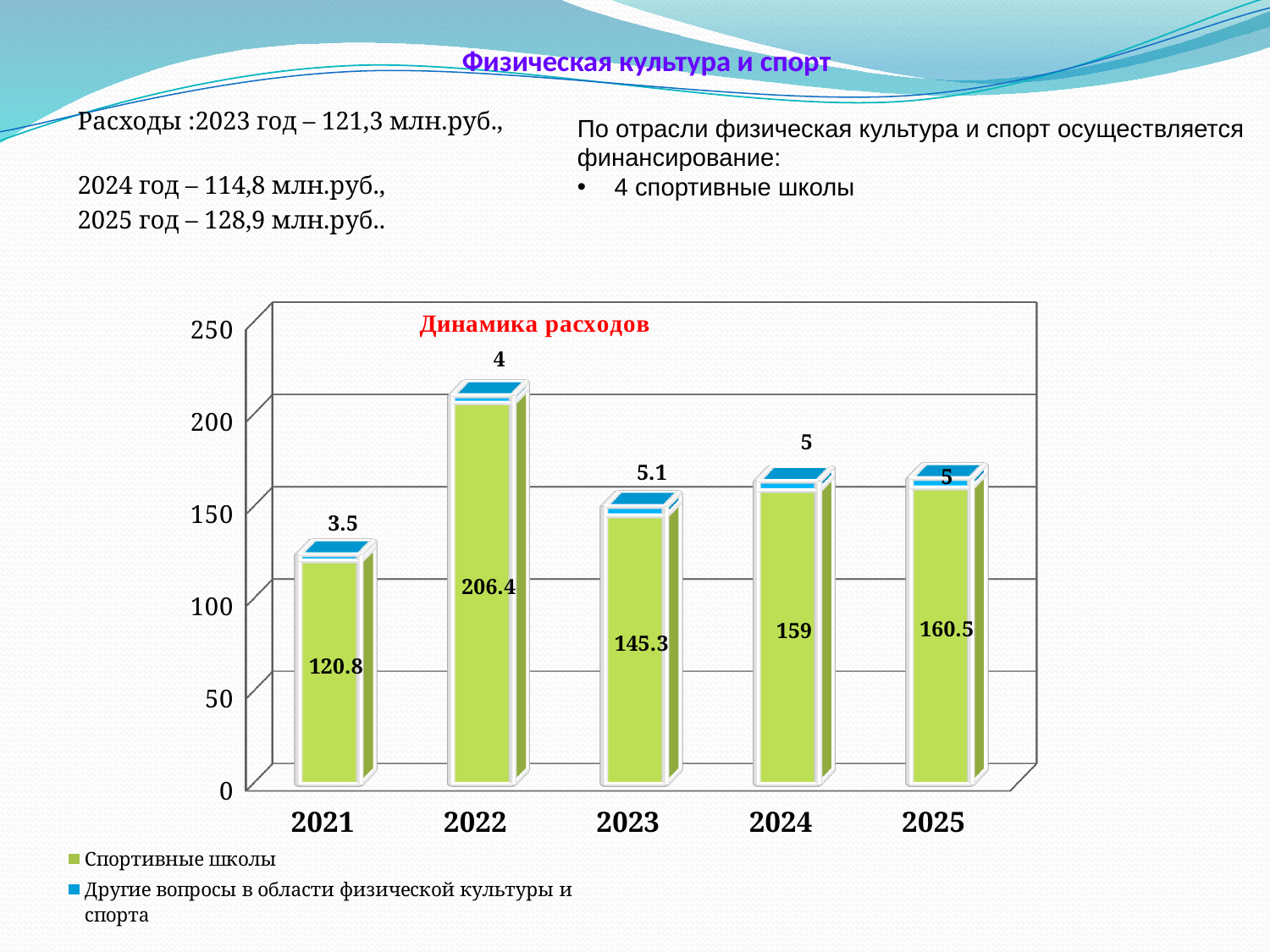
What is the difference between the Спортивные школы values for 2022 and 2021? 85.6 What is the value for Спортивные школы in 2022? 206.4 What is the title of the chart? Динамика расходов Which is larger, the Спортивные школы value for 2023 or for 2024? 2024 Which year has the highest value for Спортивные школы? 2022 What is the total of the stacked bar for 2024? 164 How many years are shown on the x axis? 5 What kind of chart is shown on the slide? Stacked bar chart Which year has the lowest value for Другие вопросы в области физической культуры и спорта? 2021 What is the value for Другие вопросы в области физической культуры и спорта in 2023? 5.1 What is the value for Спортивные школы in 2025? 160.5 How many series does the legend list? 2